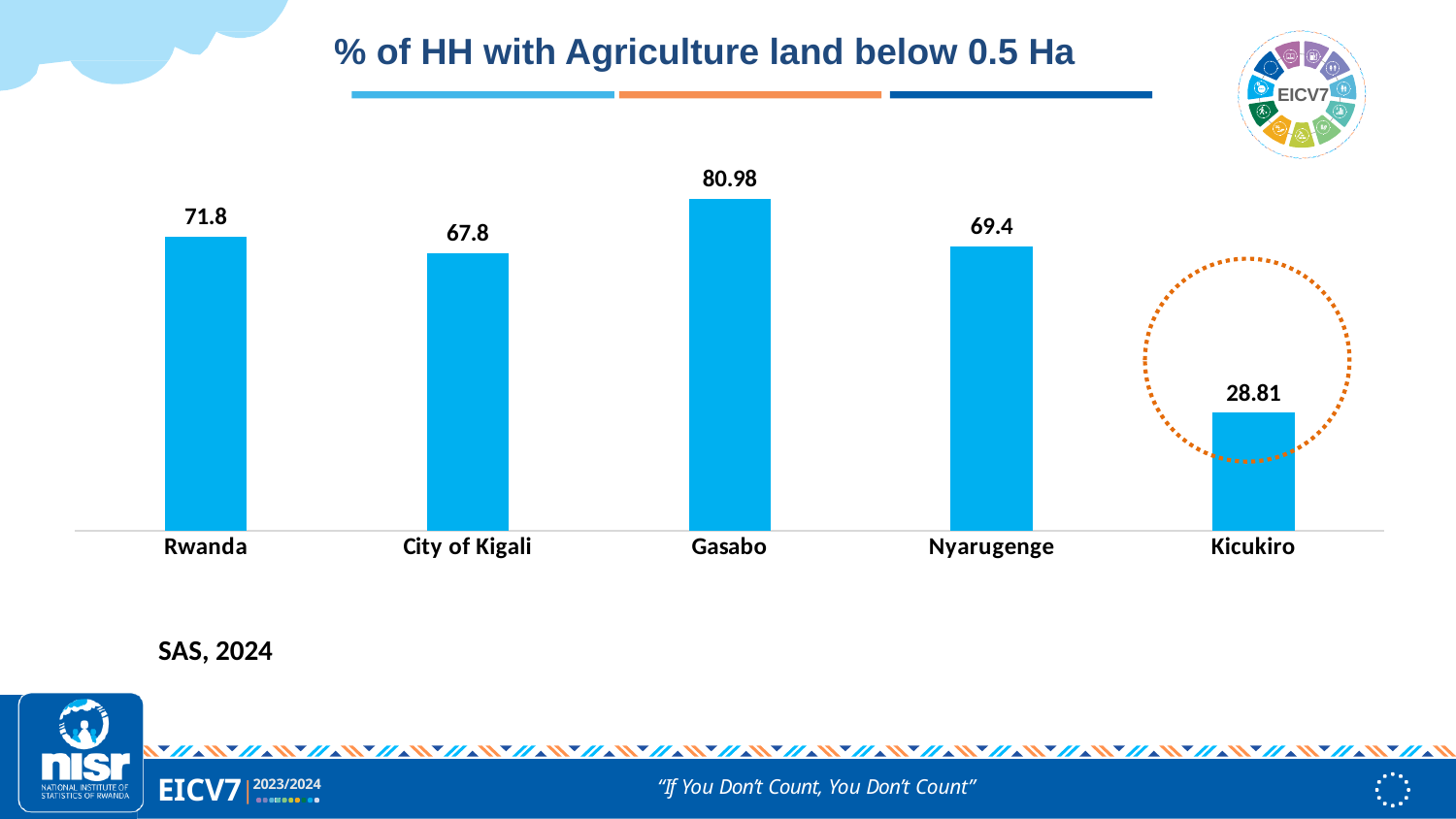
Which is larger, the value for Nyarugenge or the value for City of Kigali? Nyarugenge What is the value for Kicukiro? 28.81 What is the value for Rwanda? 71.8 What is the difference between the values for Rwanda and City of Kigali? 4 Which category has the highest value? Gasabo Which category has the lowest value? Kicukiro What is the value for Gasabo? 80.98 How many categories are shown on the chart? 5 What is the difference between the values for Gasabo and Kicukiro? 52.17 What kind of chart is shown on the slide? Bar chart What is the value for City of Kigali? 67.8 What is the value for Nyarugenge? 69.4